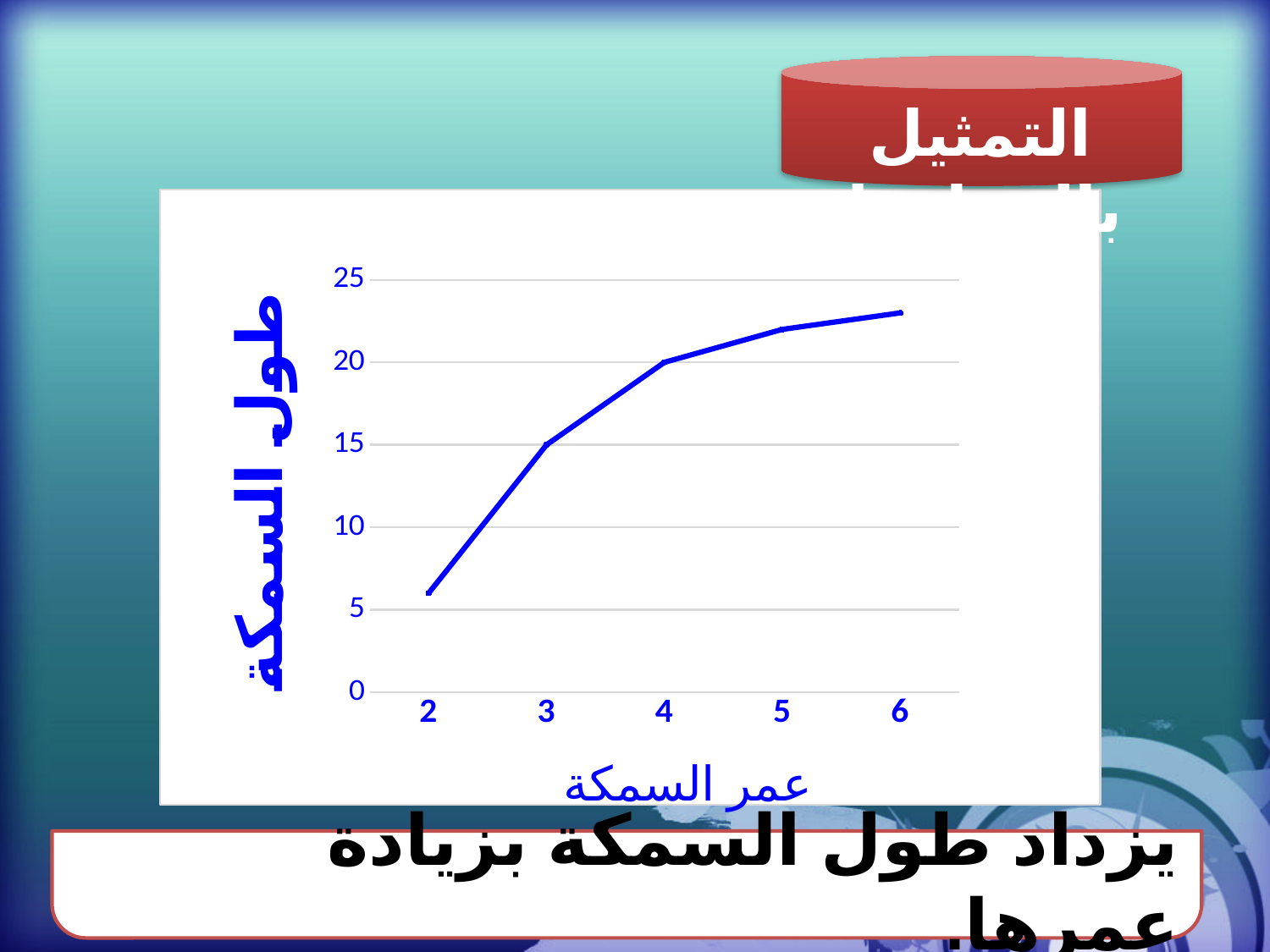
Which is larger: the fish length at age 3 or at age 5? age 5 Is the fish length at age 2 greater or less than 10? less What is the difference between the fish length at age 4 and at age 3? 5 At which fish age is the fish length lowest? 2 Is the fish length at age 6 greater or less than 20? greater What kind of chart is shown on the slide? line chart What is the fish length (طول السمكة) at age 4? 20 At which fish age is the fish length highest? 6 Is the fish length at age 5 greater or less than 25? less Does the fish length (طول السمكة) rise or fall as the fish age (عمر السمكة) increases along the x axis? rise How many data points are plotted on the line? 5 What is the fish length (طول السمكة) at age 3? 15